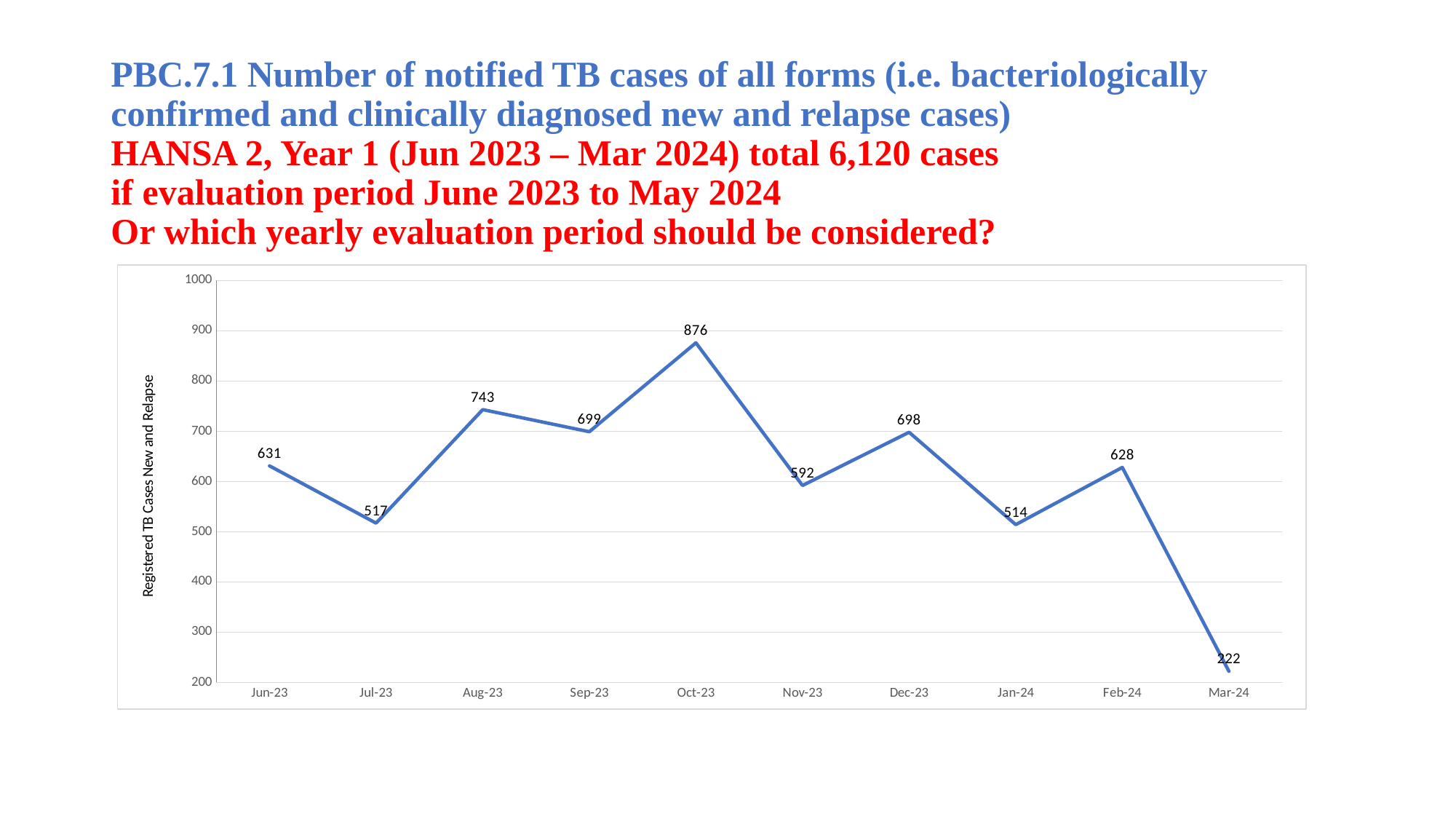
How many months are plotted on the chart? 10 What is the value for Mar-24? 222 What is the difference between the values for Feb-24 and Mar-24? 406 What is the value for Jun-23? 631 What kind of chart is shown on the slide? line chart What is the label of the vertical axis? Registered TB Cases New and Relapse Which month has the lowest number of registered TB cases? Mar-24 What is the value for Oct-23? 876 What is the difference between the values for Oct-23 and Nov-23? 284 Is the value for Jan-24 greater or less than 600? less Which is larger, the value for Aug-23 or the value for Dec-23? Aug-23 Which month has the highest number of registered TB cases? Oct-23